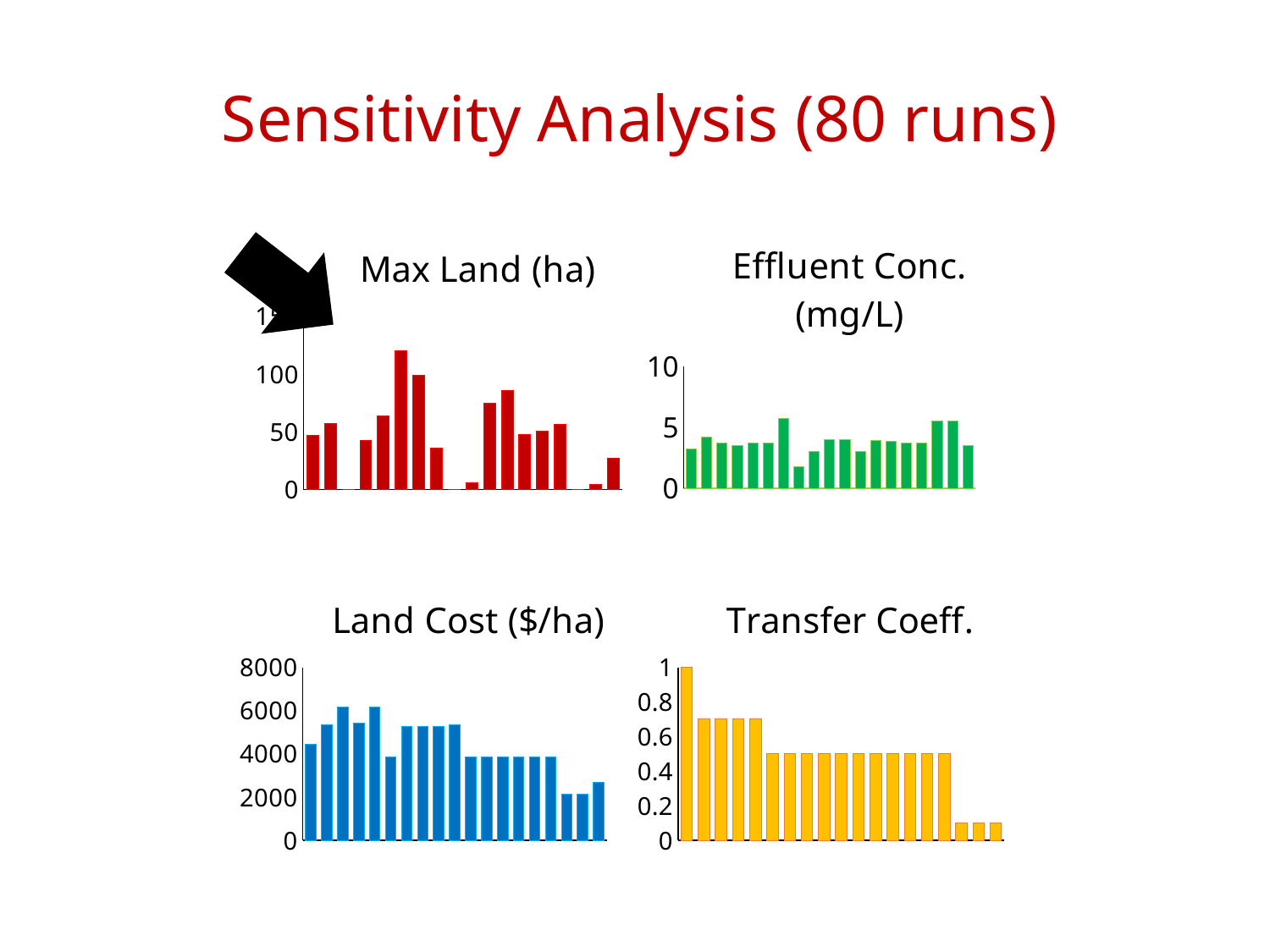
In the 'Transfer Coeff.' chart, do the values rise or fall from left to right? fall In the 'Land Cost ($/ha)' chart, is the value of the first bar greater or less than 4000? greater What is the title of the top-right chart? Effluent Conc. (mg/L) In the 'Effluent Conc. (mg/L)' chart, is the value of the tallest bar greater or less than 5? greater In the 'Effluent Conc. (mg/L)' chart, is the value of the shortest bar greater or less than 5? less In the 'Transfer Coeff.' chart, what is the value of the first bar? 1 What kind of chart is the 'Max Land (ha)' chart? bar chart How many charts are shown on the slide? 4 In the 'Transfer Coeff.' chart, which is larger, the first bar or the last bar? the first bar